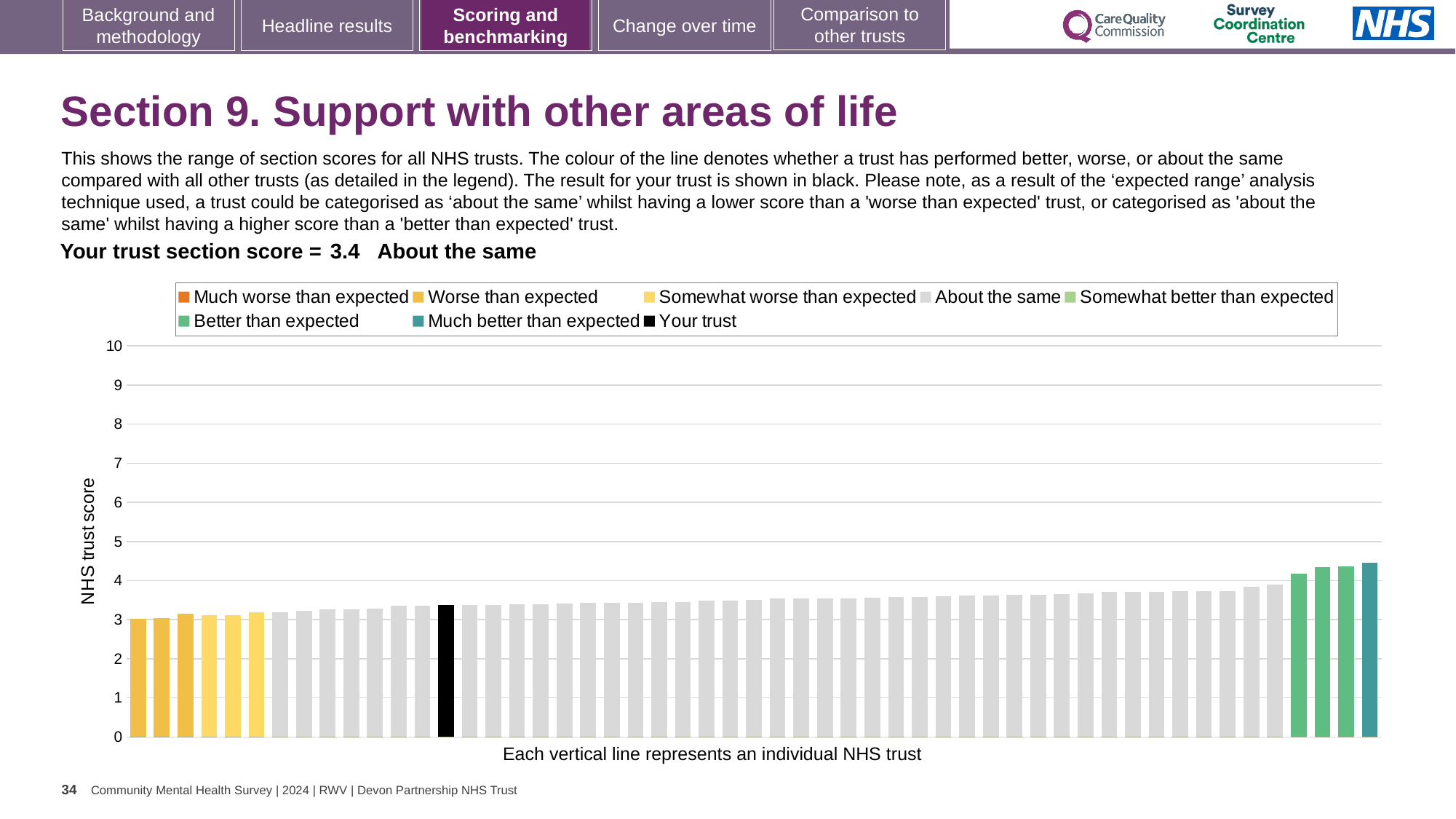
What is the label on the y axis of the chart? NHS trust score Do the bar values rise or fall from left to right along the x axis? rise Is the value of the black 'Your trust' bar greater or less than 4? less Which performance category is your trust placed in according to the slide? About the same What kind of chart is shown on the slide? Bar chart What is the section score for your trust shown on the slide? 3.4 Which legend category does the tallest bar belong to? Much better than expected Is the value of the tallest bar (the rightmost bar) greater or less than 5? less Is the value of the leftmost bar greater or less than 2? greater How many entries does the chart legend list? 8